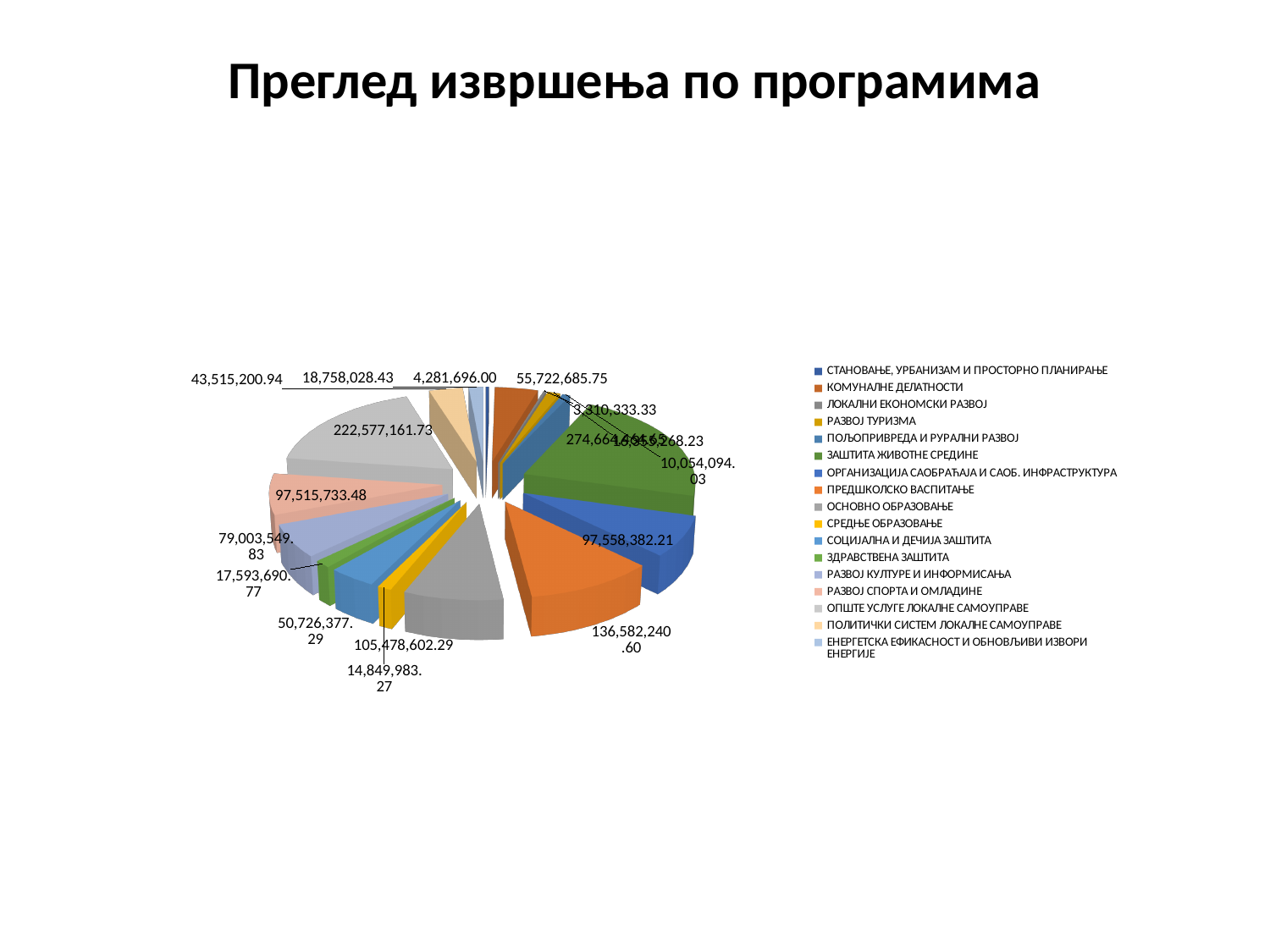
Which is larger, the slice labelled 136,582,240.60 or the slice labelled 105,478,602.29? 136,582,240.60 How many entries does the legend of the pie chart list? 17 What is the difference between the slice labelled 222,577,161.73 and the slice labelled 136,582,240.60? 85,994,921.13 What value is shown for the ПОЛИТИЧКИ СИСТЕМ ЛОКАЛНЕ САМОУПРАВЕ slice? 43,515,200.94 What is the last entry listed in the legend? ЕНЕРГЕТСКА ЕФИКАСНОСТ И ОБНОВЉИВИ ИЗВОРИ ЕНЕРГИЈЕ What is the smallest data label printed on the pie chart? 3,310,333.33 What value is shown for the РАЗВОЈ СПОРТА И ОМЛАДИНЕ slice? 97,515,733.48 What value is shown for the ПРЕДШКОЛСКО ВАСПИТАЊЕ slice? 136,582,240.60 What kind of chart is shown on the slide? pie chart What is the title of the slide? Преглед извршења по програмима What value is shown for the ОПШТЕ УСЛУГЕ ЛОКАЛНЕ САМОУПРАВЕ slice? 222,577,161.73 Which is larger, the slice for РАЗВОЈ СПОРТА И ОМЛАДИНЕ or the slice for ПОЛИТИЧКИ СИСТЕМ ЛОКАЛНЕ САМОУПРАВЕ? РАЗВОЈ СПОРТА И ОМЛАДИНЕ